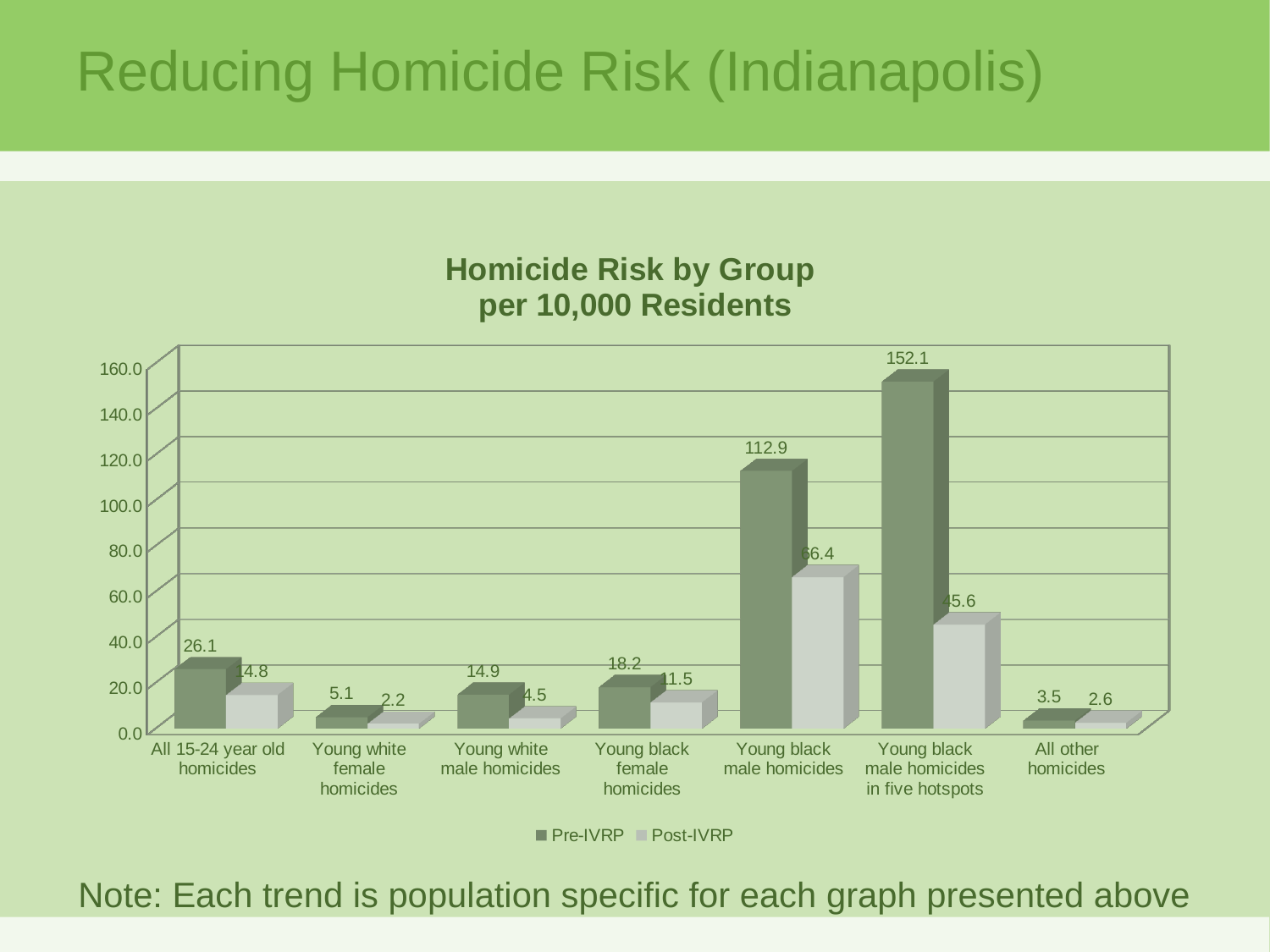
Is the Pre-IVRP value for Young black male homicides greater or less than 100? greater What is the Pre-IVRP value for All 15-24 year old homicides? 26.1 What is the Post-IVRP value for Young white female homicides? 2.2 What is the difference between the Pre-IVRP and Post-IVRP values for Young black male homicides in five hotspots? 106.5 How many series does the legend list? 2 How many groups are shown on the x axis? 7 What kind of chart is shown? Bar chart What is the Post-IVRP value for Young black male homicides? 66.4 What is the Pre-IVRP value for Young black male homicides in five hotspots? 152.1 Which is larger: the Pre-IVRP value for Young black female homicides or the Pre-IVRP value for Young white male homicides? Young black female homicides Which group has the lowest Post-IVRP value? Young white female homicides Which group has the highest Pre-IVRP value? Young black male homicides in five hotspots